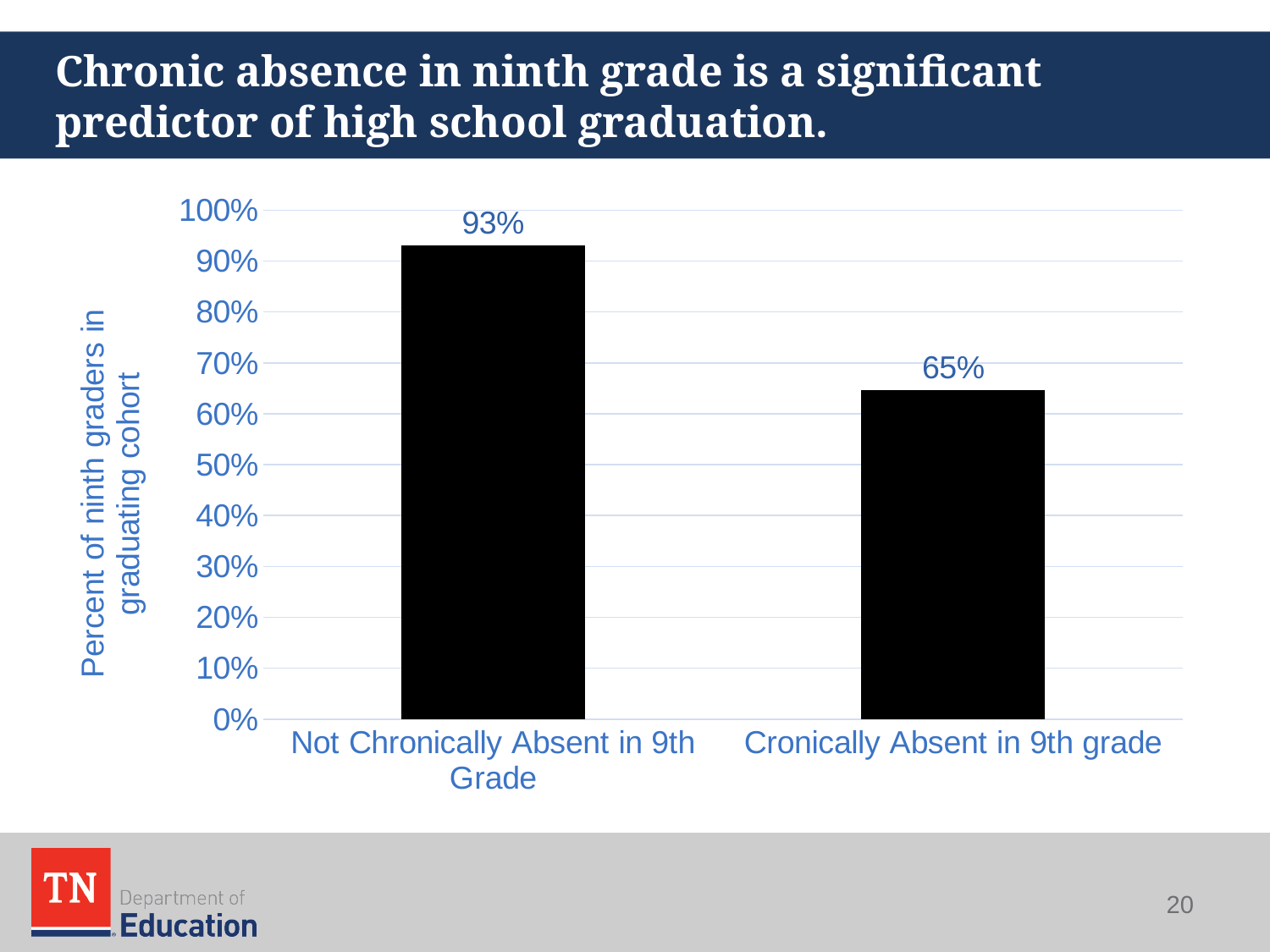
What is the value for Cronically Absent in 9th grade? 65% What is the label of the vertical axis? Percent of ninth graders in graduating cohort Which category has the lowest value? Cronically Absent in 9th grade Which category has the highest value? Not Chronically Absent in 9th Grade Is the value for Not Chronically Absent in 9th Grade greater or less than 90%? greater What kind of chart is shown on the slide? bar chart What is the difference between the values for Not Chronically Absent in 9th Grade and Cronically Absent in 9th grade? 28% What colour are the bars in the chart? black What is the value for Not Chronically Absent in 9th Grade? 93% Is the value for Cronically Absent in 9th grade greater or less than 70%? less How many categories are shown on the x axis? 2 Which is larger, the value for Not Chronically Absent in 9th Grade or the value for Cronically Absent in 9th grade? Not Chronically Absent in 9th Grade